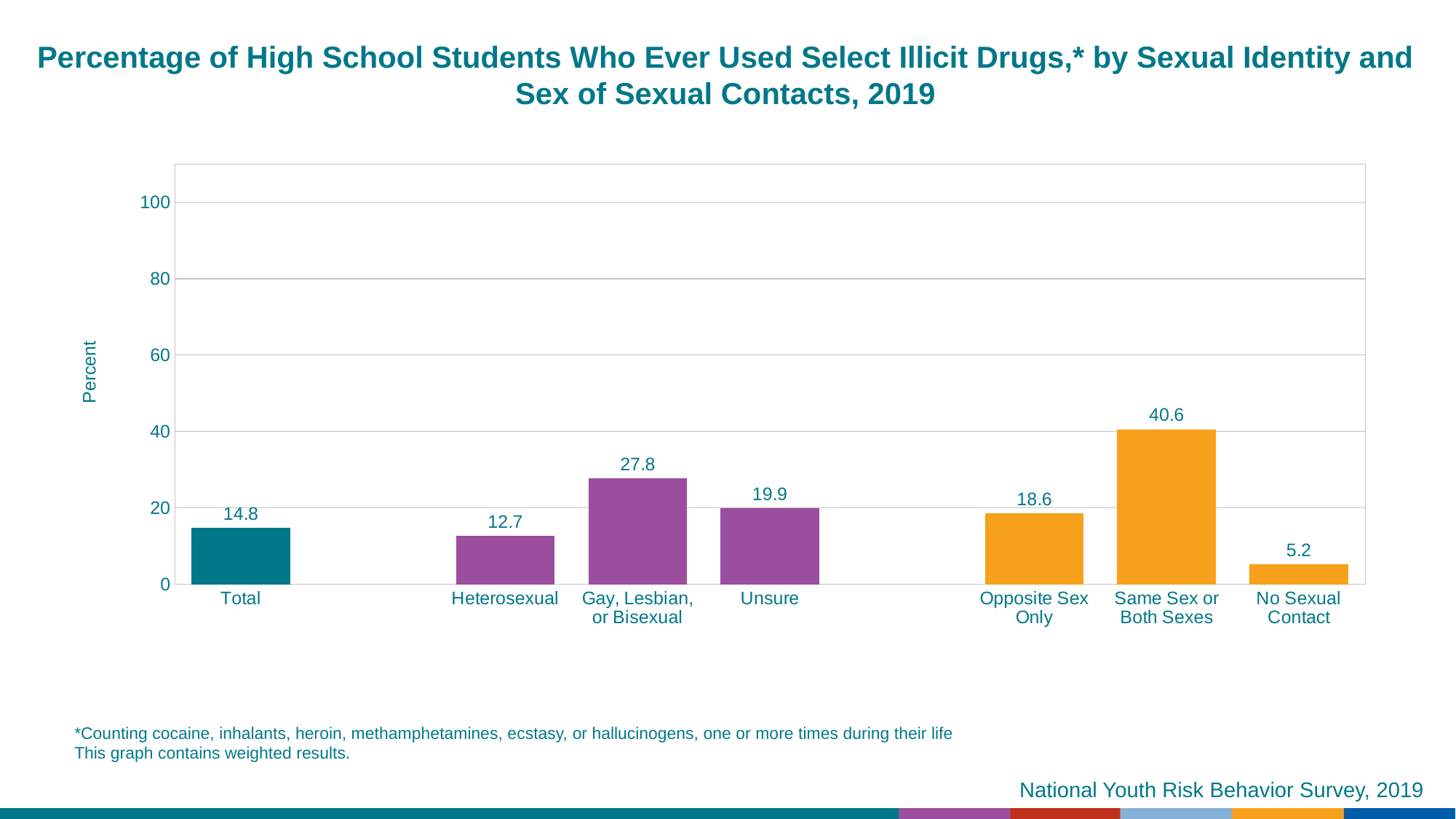
How many bars are shown in the chart? 7 Is the value for Same Sex or Both Sexes greater or less than 40? greater What kind of chart is shown on the slide? bar chart What is the difference between the values for Gay, Lesbian, or Bisexual and Heterosexual? 15.1 Which category has the highest value? Same Sex or Both Sexes Which category has the lowest value? No Sexual Contact What is the value for Same Sex or Both Sexes? 40.6 What is the value for Total? 14.8 What is the difference between the values for Same Sex or Both Sexes and Opposite Sex Only? 22.0 What is the value for No Sexual Contact? 5.2 Which is larger, the value for Unsure or the value for Opposite Sex Only? Unsure What is the value for Gay, Lesbian, or Bisexual students? 27.8